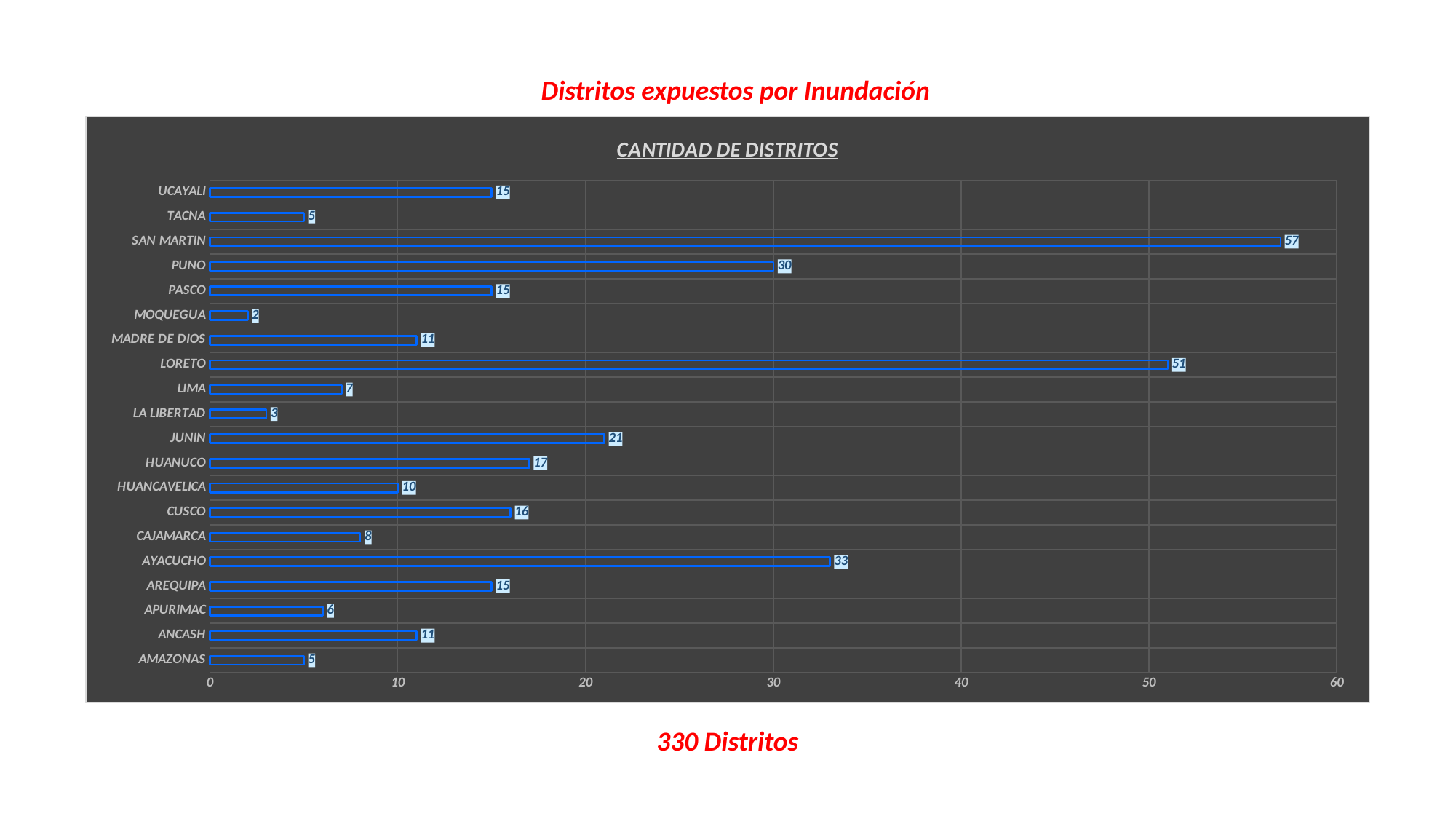
What is the value for MADRE DE DIOS? 11 Which is larger, the value for HUANUCO or the value for CUSCO? HUANUCO What is the title shown inside the chart area? CANTIDAD DE DISTRITOS What is the difference between the values for PUNO and JUNIN? 9 What is the difference between the values for SAN MARTIN and LORETO? 6 What is the value for SAN MARTIN? 57 Which category has the lowest value? MOQUEGUA What kind of chart is shown on the slide? bar chart Which category has the highest value? SAN MARTIN What is the value for AYACUCHO? 33 How many categories are shown in the chart? 20 Is the value for LORETO greater or less than 50? greater